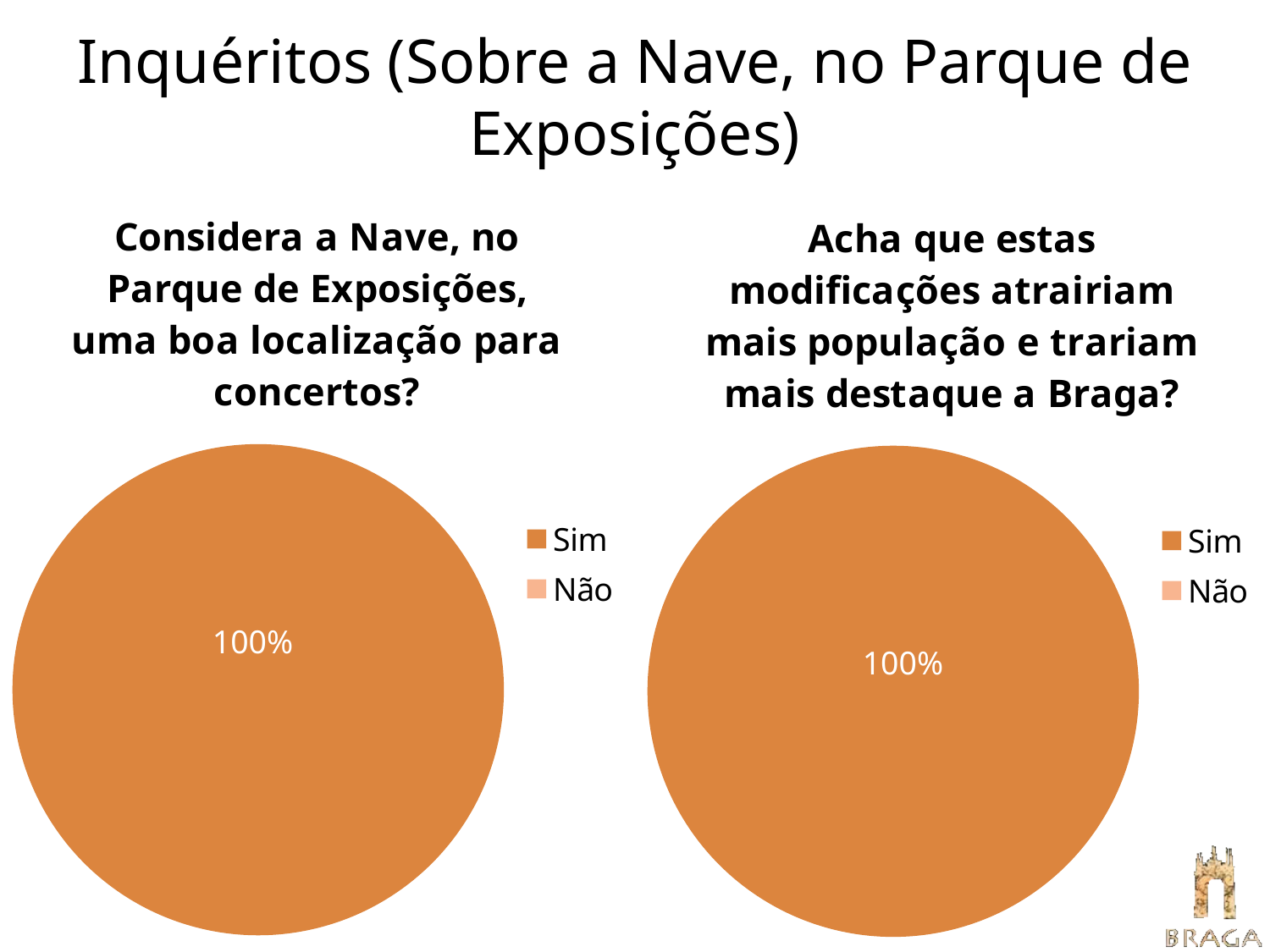
What kind of chart is the left chart ("Considera a Nave, no Parque de Exposições, uma boa localização para concertos?")? Pie chart How many entries does the legend of the right chart ("Acha que estas modificações atrairiam mais população e trariam mais destaque a Braga?") list? 2 How many pie charts are shown on the slide? 2 In the left chart ("Considera a Nave, no Parque de Exposições, uma boa localização para concertos?"), what percentage is printed on the pie? 100% How many entries does the legend of the left chart ("Considera a Nave, no Parque de Exposições, uma boa localização para concertos?") list? 2 In the left chart ("Considera a Nave, no Parque de Exposições, uma boa localização para concertos?"), which category has the largest share? Sim In the left chart ("Considera a Nave, no Parque de Exposições, uma boa localização para concertos?"), what share of the pie is labelled 100%? Sim In the right chart ("Acha que estas modificações atrairiam mais população e trariam mais destaque a Braga?"), which category has the largest share? Sim What are the two legend entries of the left chart ("Considera a Nave, no Parque de Exposições, uma boa localização para concertos?")? Sim and Não In the right chart ("Acha que estas modificações atrairiam mais população e trariam mais destaque a Braga?"), which is larger, Sim or Não? Sim What kind of chart is the right chart ("Acha que estas modificações atrairiam mais população e trariam mais destaque a Braga?")? Pie chart In the right chart ("Acha que estas modificações atrairiam mais população e trariam mais destaque a Braga?"), what percentage is shown on the pie? 100%